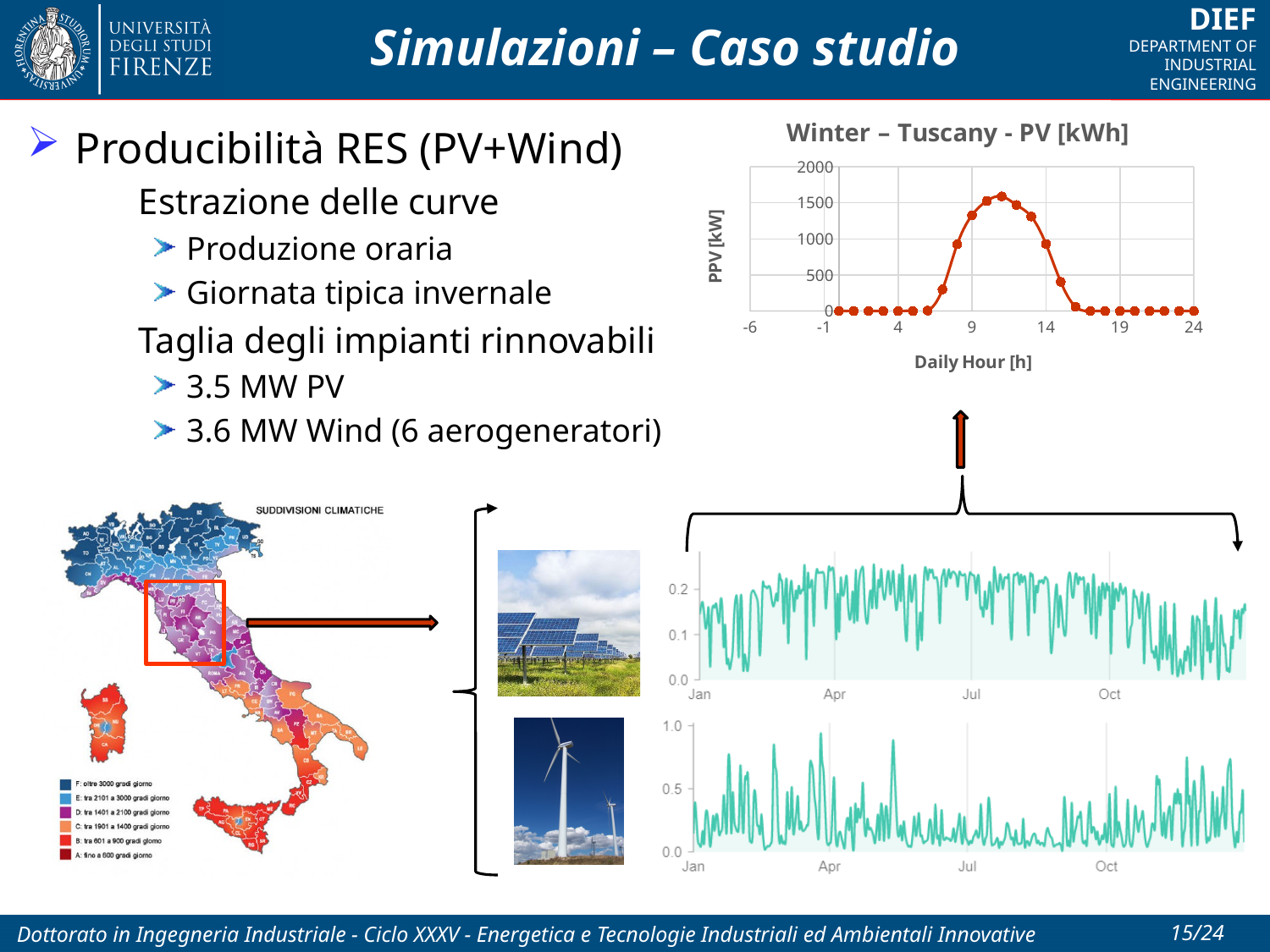
In the 'Winter – Tuscany - PV [kWh]' chart, how do the values change between daily hour 14 and daily hour 19? they fall In the 'Winter – Tuscany - PV [kWh]' chart, what is the label of the y axis? PPV [kW] In the 'Winter – Tuscany - PV [kWh]' chart, is the value at daily hour 14 greater or less than 1000? less In the 'Winter – Tuscany - PV [kWh]' chart, is the value at daily hour 9 greater or less than 1000? greater In the 'Winter – Tuscany - PV [kWh]' chart, is the peak value greater or less than 1000? greater In the 'Winter – Tuscany - PV [kWh]' chart, what is the value at daily hour 4? 0 In the 'Winter – Tuscany - PV [kWh]' chart, what is the label of the x axis? Daily Hour [h] In the 'Winter – Tuscany - PV [kWh]' chart, which is larger: the value at daily hour 9 or at daily hour 14? daily hour 9 What kind of chart is the bottom-right chart with the y axis from 0.0 to 1.0? line chart In the 'Winter – Tuscany - PV [kWh]' chart, how do the values change between daily hour 4 and daily hour 9? they rise In the 'Winter – Tuscany - PV [kWh]' chart, what is the value at daily hour 19? 0 What kind of chart is the 'Winter – Tuscany - PV [kWh]' chart? line chart